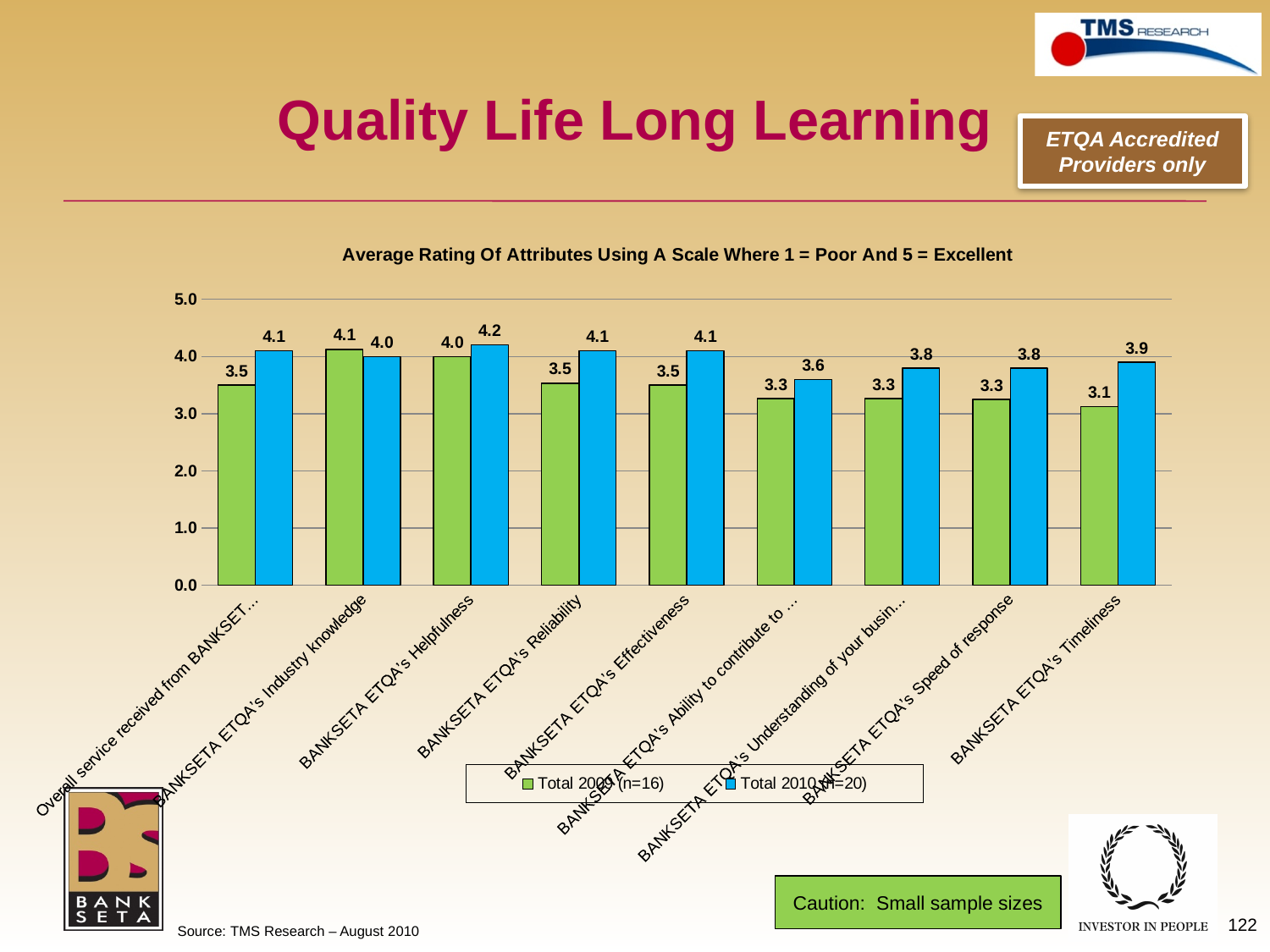
How many attributes are shown on the x axis of the chart? 9 Which attribute has the highest Total 2010 (n=20) rating? BANKSETA ETQA's Helpfulness What is the Total 2010 (n=20) rating for BANKSETA ETQA's Speed of response? 3.8 How many series does the chart legend list? 2 What is the difference between the Total 2010 (n=20) and Total 2009 (n=16) ratings for BANKSETA ETQA's Timeliness? 0.8 What is the Total 2009 (n=16) rating for BANKSETA ETQA's Industry knowledge? 4.1 What is the Total 2010 (n=20) rating for BANKSETA ETQA's Helpfulness? 4.2 What type of chart is shown on the slide? Bar chart What is the Total 2009 (n=16) rating for BANKSETA ETQA's Timeliness? 3.1 What is the title of the chart? Average Rating Of Attributes Using A Scale Where 1 = Poor And 5 = Excellent Which attribute has the lowest Total 2009 (n=16) rating? BANKSETA ETQA's Timeliness For BANKSETA ETQA's Industry knowledge, which is higher: the Total 2009 (n=16) rating or the Total 2010 (n=20) rating? Total 2009 (n=16)